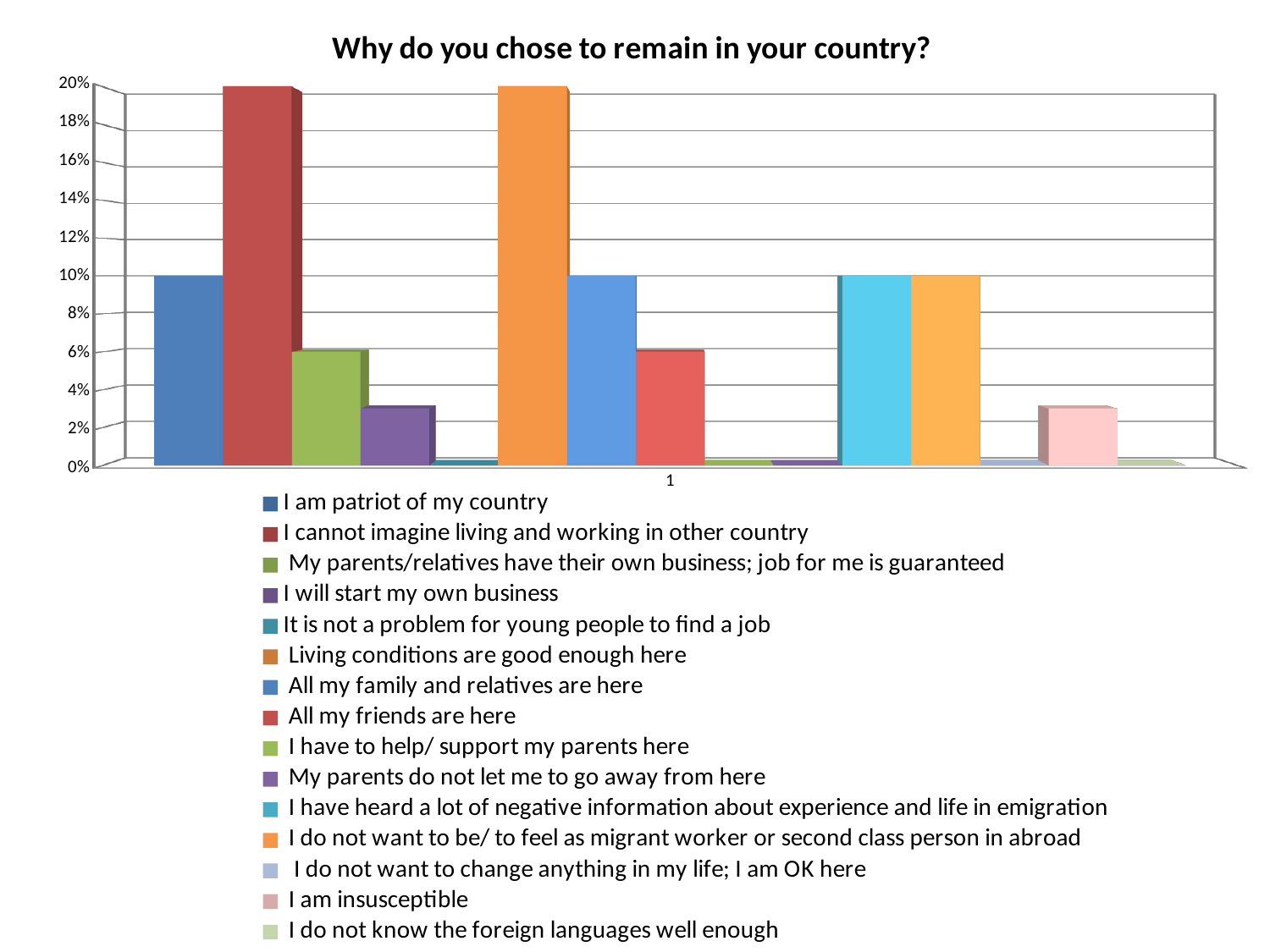
What kind of chart is shown on the slide? bar chart Which is larger: the value for "I cannot imagine living and working in other country" or the value for "I am patriot of my country"? I cannot imagine living and working in other country What is the value for "My parents/relatives have their own business; job for me is guaranteed"? 6% What is the value for "I am patriot of my country"? 10% What is the difference between the value for "I cannot imagine living and working in other country" and the value for "I am patriot of my country"? 10% What is the value for "Living conditions are good enough here"? 20% What is the title of the chart? Why do you chose to remain in your country? How many series does the legend list? 15 What is the value for "I cannot imagine living and working in other country"? 20% Is the value for "I will start my own business" greater or less than 4%? less Which is larger: the value for "All my family and relatives are here" or the value for "All my friends are here"? All my family and relatives are here What is the value for "All my friends are here"? 6%